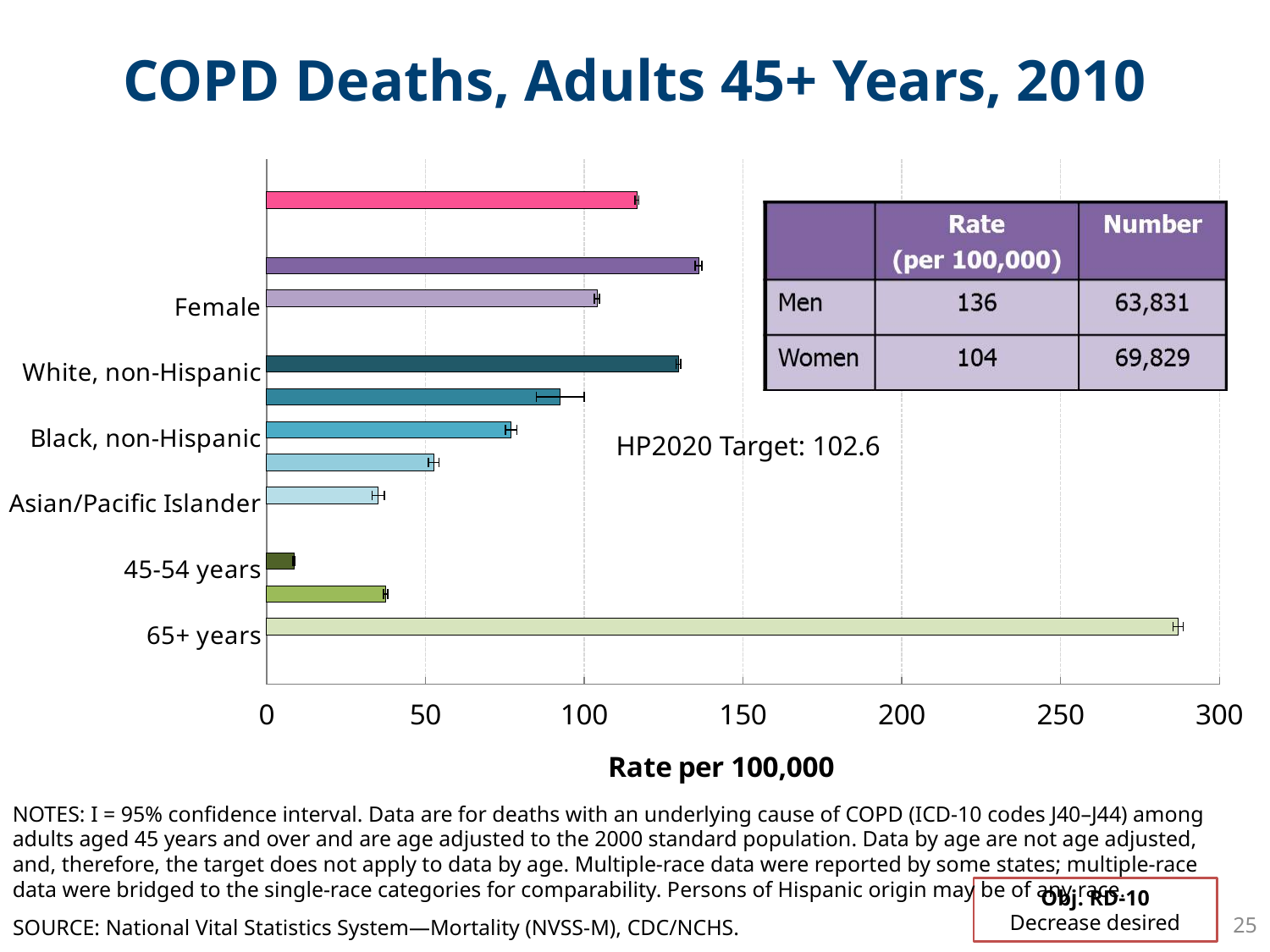
According to the table on the slide, what is the COPD death rate per 100,000 for Men? 136 What kind of chart is shown on the slide? bar chart Which is larger, the rate for White, non-Hispanic or for Black, non-Hispanic? White, non-Hispanic What is the difference between the rates for Men and Women shown in the table? 32 Which labeled category has the lowest rate? 45-54 years Which labeled category has the highest rate? 65+ years According to the table on the slide, what is the number of COPD deaths for Women? 69,829 What is the title of the chart's horizontal axis? Rate per 100,000 What is the HP2020 Target value shown on the slide? 102.6 Is the value for White, non-Hispanic greater or less than 100? greater Is the value for Asian/Pacific Islander greater or less than 50? less Is the value for 65+ years greater or less than 250? greater